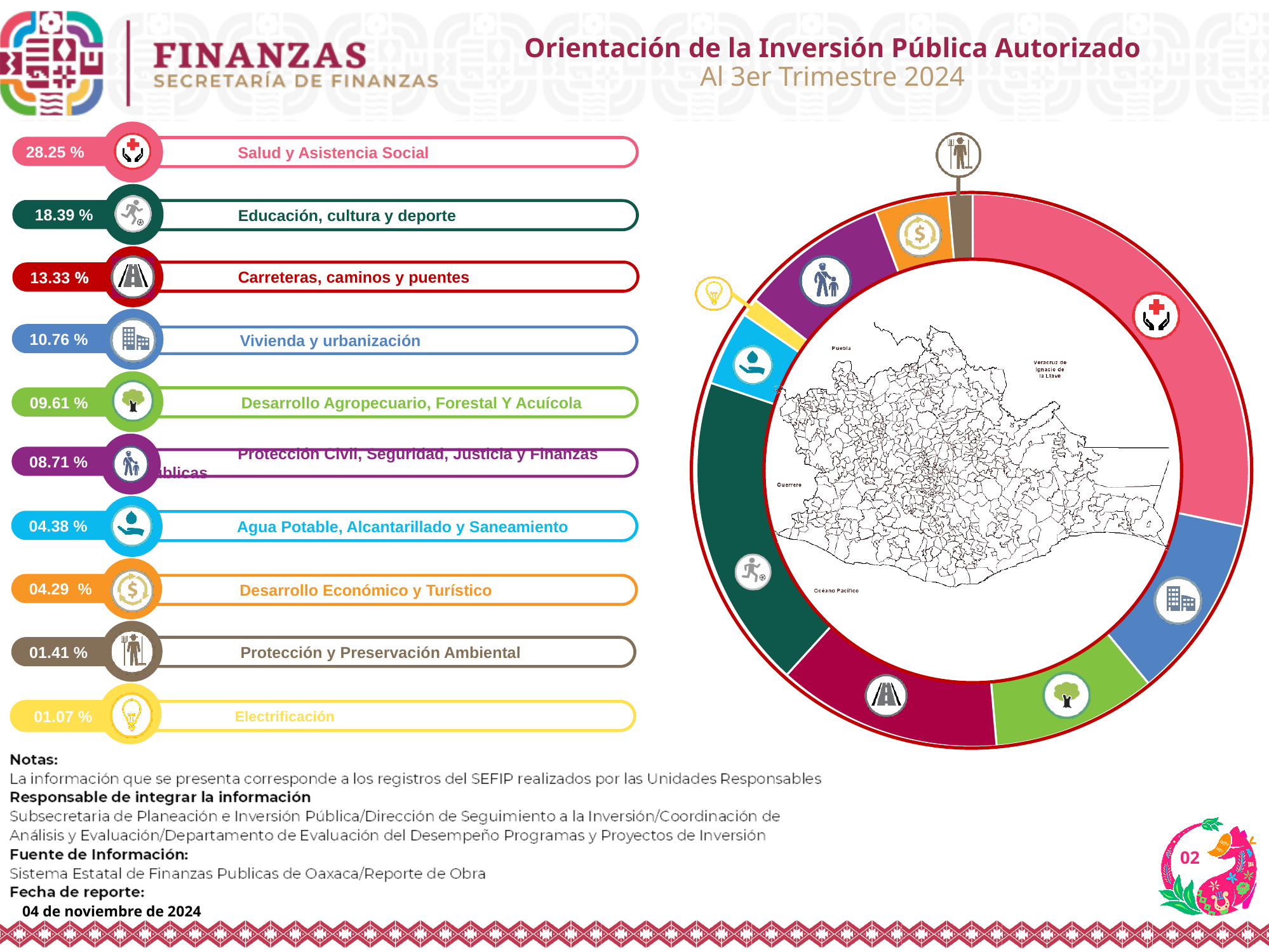
What colour represents Salud y Asistencia Social in the chart? Pink Which category has the largest share of the authorized public investment? Salud y Asistencia Social Which has a larger share: Vivienda y urbanización or Desarrollo Agropecuario, Forestal Y Acuícola? Vivienda y urbanización What is the difference in percentage points between Salud y Asistencia Social and Educación, cultura y deporte? 9.86 What kind of chart is used to show the distribution of the authorized public investment? Donut (pie) chart Which category has the smallest share of the authorized public investment? Electrificación What percentage is shown for Protección y Preservación Ambiental? 01.41 % How many categories are shown in the chart? 10 What percentage is shown for Carreteras, caminos y puentes? 13.33 % What percentage is shown for Agua Potable, Alcantarillado y Saneamiento? 04.38 % What share of the authorized public investment goes to Salud y Asistencia Social? 28.25 % Which has a larger share: Agua Potable, Alcantarillado y Saneamiento or Desarrollo Económico y Turístico? Agua Potable, Alcantarillado y Saneamiento